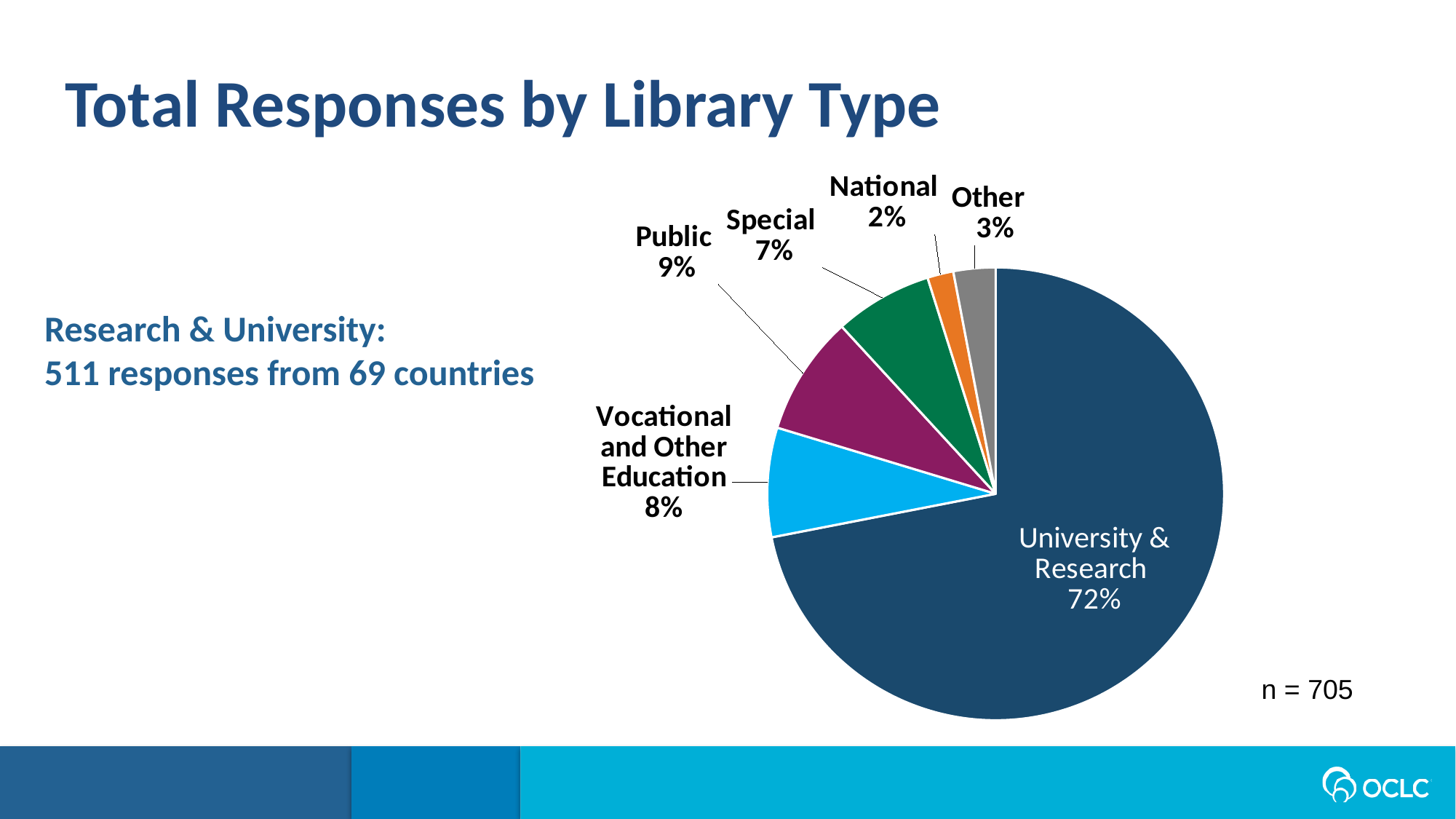
What kind of chart is shown on the slide? Pie chart What is the title of the chart on the slide? Total Responses by Library Type What is the total number of responses (n) shown on the slide? 705 Which library type has the largest share of responses? University & Research What percentage of responses is from Vocational and Other Education libraries? 8% Which slice is larger, Other or National? Other What is the difference in percentage points between the Public and Special slices? 2 What share of total responses comes from University & Research libraries? 72% What percentage of responses is from Special libraries? 7% Which library type has the smallest share of responses? National How many library types are shown in the pie chart? 6 What percentage of responses is from Public libraries? 9%